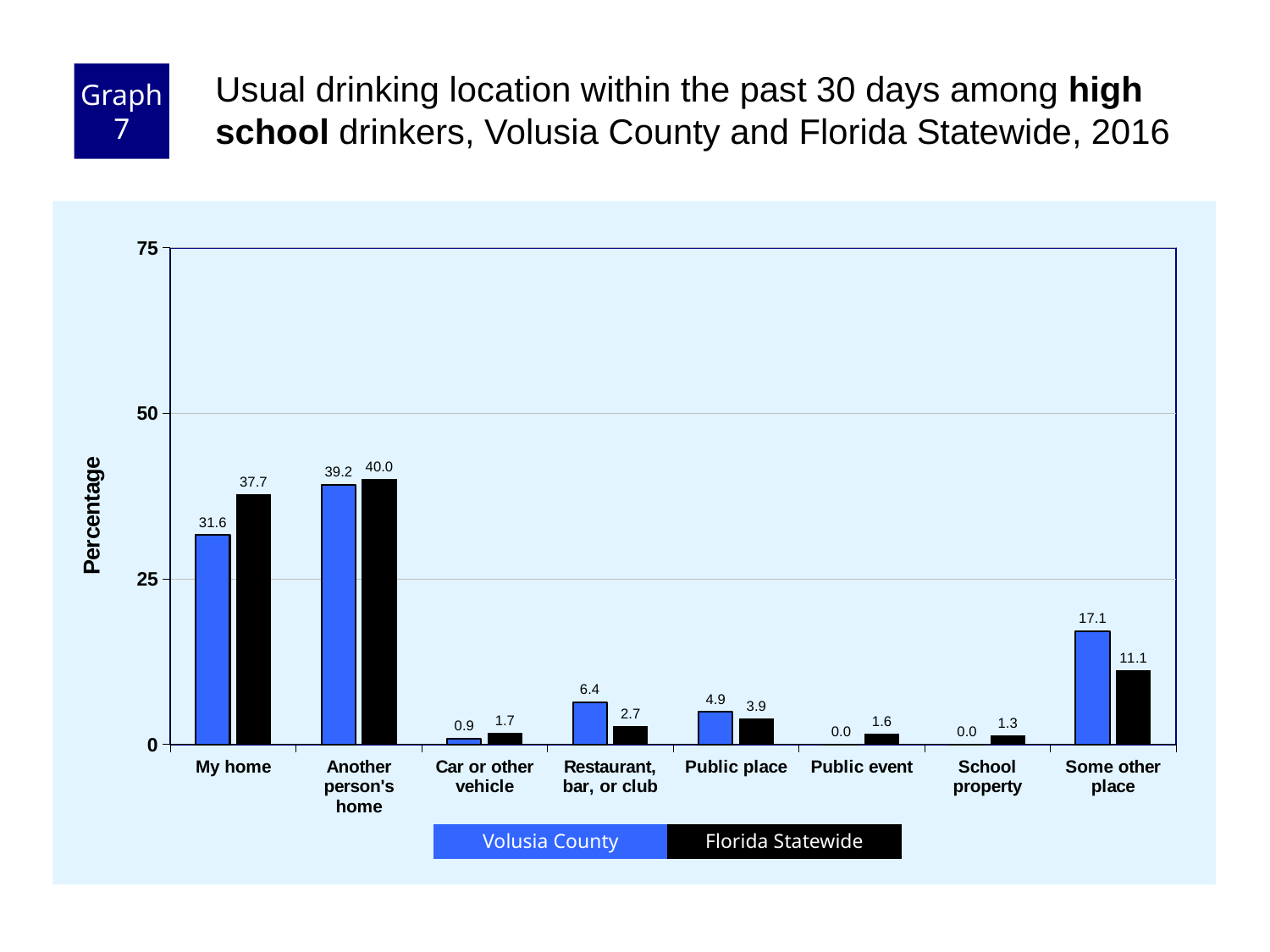
Is the Volusia County value for "Another person's home" greater or less than 25? greater What is the difference between the Florida Statewide and Volusia County values for "My home"? 6.1 How many series does the legend list? 2 Which is larger for "Some other place": Volusia County or Florida Statewide? Volusia County What is the Florida Statewide value for "Some other place"? 11.1 Which category has the lowest Florida Statewide value? School property What is the label on the y axis? Percentage How many categories are shown on the x axis? 8 What is the Volusia County value for "Restaurant, bar, or club"? 6.4 What kind of chart is shown on the slide? Bar chart Which category has the highest Florida Statewide value? Another person's home What is the Volusia County value for "My home"? 31.6